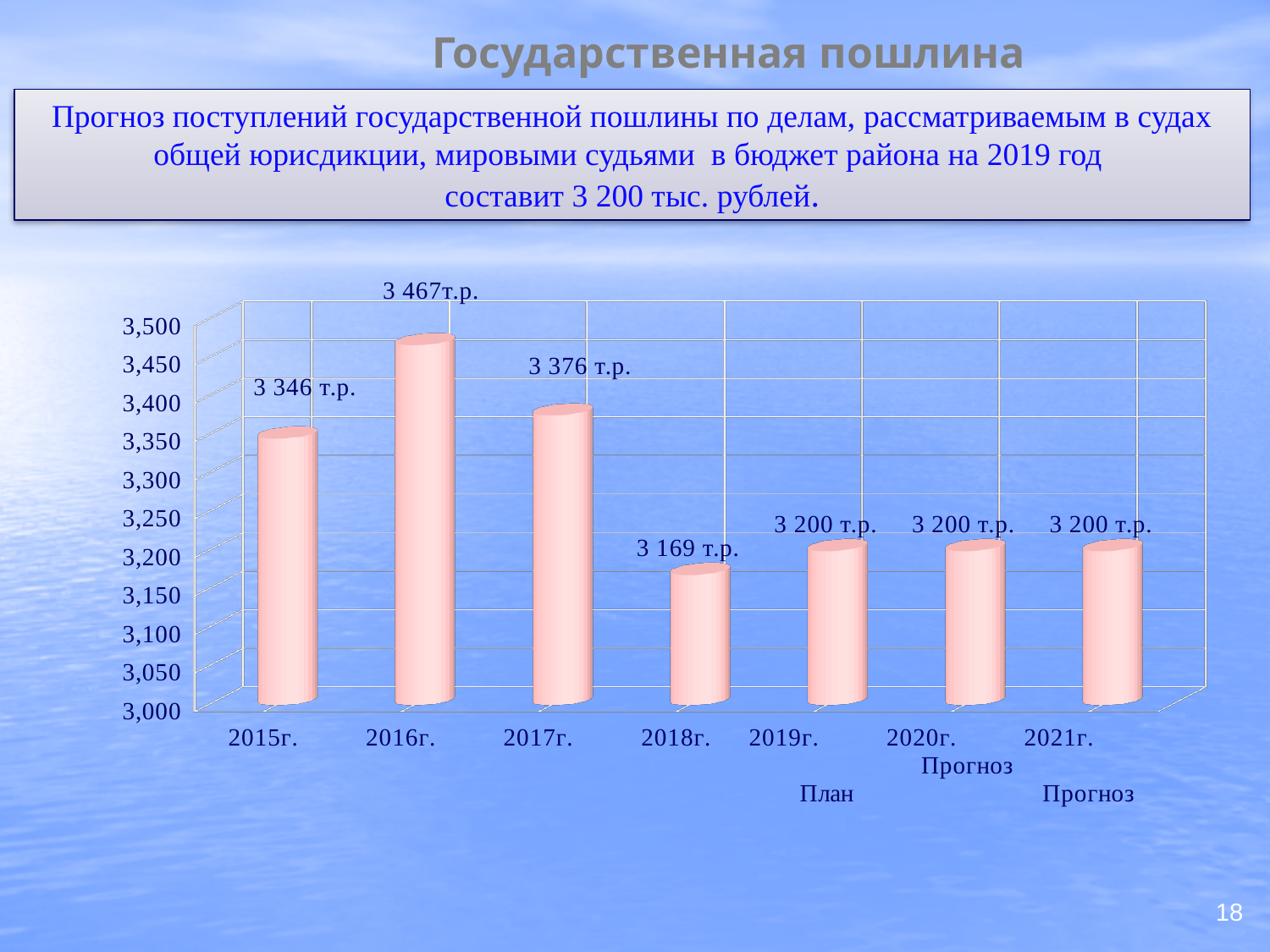
Which year has the lowest value? 2018г. What kind of chart is shown on the slide? bar chart Do the values rise or fall from 2016г. to 2018г.? fall Is the value for 2018г. greater or less than 3,200? less What is the difference between the values for 2017г. and 2018г.? 207 т.р. What is the difference between the values for 2016г. and 2015г.? 121 т.р. What is the value for 2019г. (План)? 3 200 т.р. Which year has the highest value? 2016г. Which is larger, the value for 2017г. or the value for 2015г.? 2017г. What is the value for 2018г.? 3 169 т.р. What is the value for 2015г.? 3 346 т.р. How many years are shown on the x axis? 7